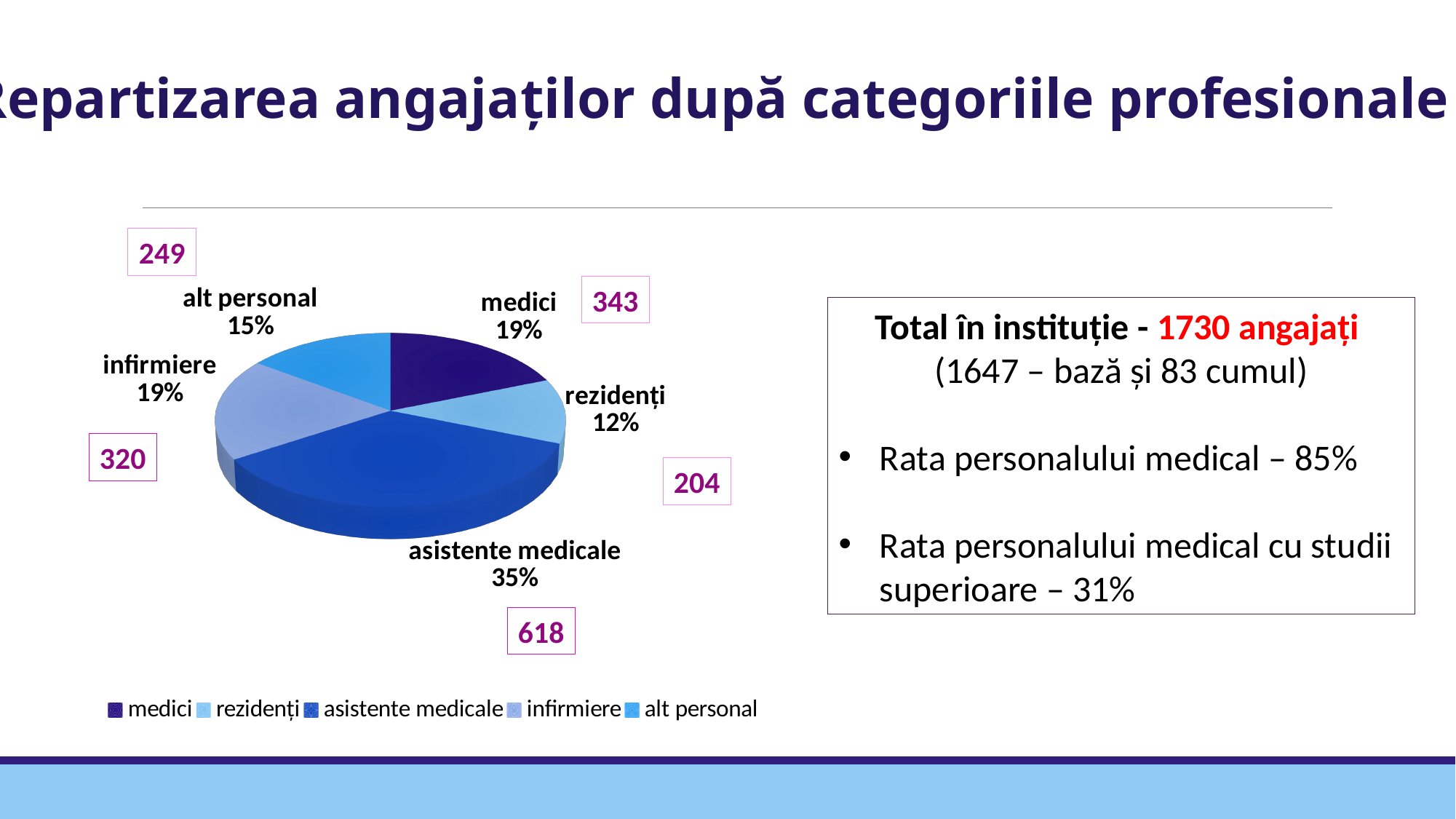
What is the title of the slide containing the chart? Repartizarea angajaților după categoriile profesionale Which is larger, the number for alt personal or the number for rezidenți? alt personal What is the number shown for infirmiere? 320 Which category has the largest slice of the pie? asistente medicale What share of the pie does alt personal represent? 15% What is the number shown for medici? 343 How many categories does the pie chart have? 5 What kind of chart is shown on the slide? pie chart Which category has the smallest slice of the pie? rezidenți What share of the pie does rezidenți represent? 12% What share of the pie does asistente medicale represent? 35% What is the difference between the number for asistente medicale and the number for medici? 275